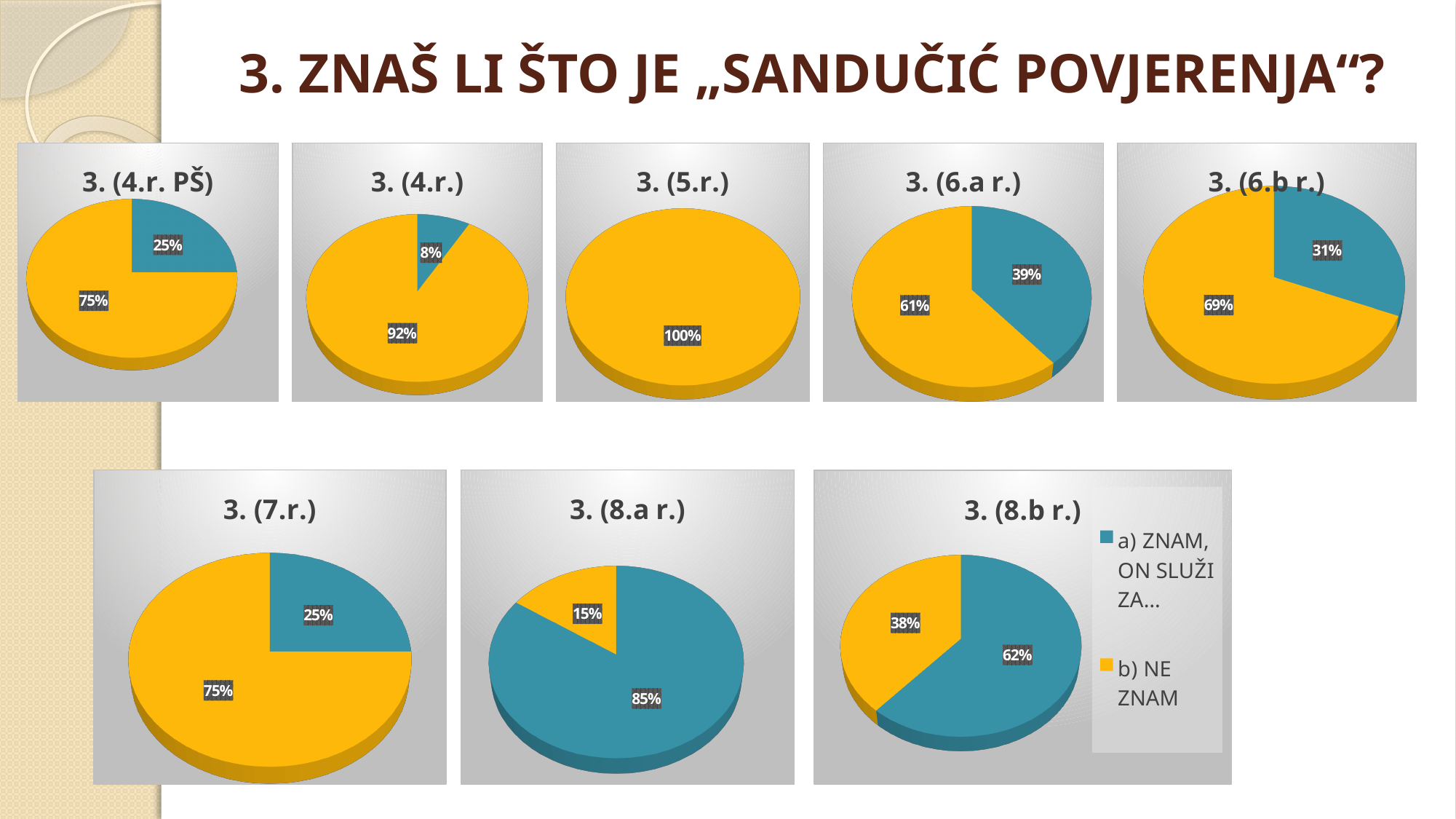
Which colour represents "b) NE ZNAM" in the legend? yellow In the chart titled "3. (4.r. PŠ)", what percentage is shown for the teal slice (a) ZNAM, ON SLUŽI ZA...)? 25% In the chart titled "3. (5.r.)", what percentage does the single slice show? 100% In the chart titled "3. (7.r.)", what share of the pie does the yellow slice take? 75% In the chart titled "3. (6.b r.)", which slice is larger, the teal one or the yellow one? the yellow one (69%) In the chart titled "3. (8.b r.)", what percentage is shown for b) NE ZNAM? 38% How many pie charts are shown on the slide? 8 In the chart titled "3. (4.r.)", what percentage is shown for the yellow slice (b) NE ZNAM)? 92% In the chart titled "3. (8.a r.)", what percentage is shown for the teal slice? 85% In the chart titled "3. (6.a r.)", what is the difference between the yellow slice and the teal slice? 22% What kind of chart is used for "3. (7.r.)"? pie chart How many entries does the legend next to the chart titled "3. (8.b r.)" list? 2